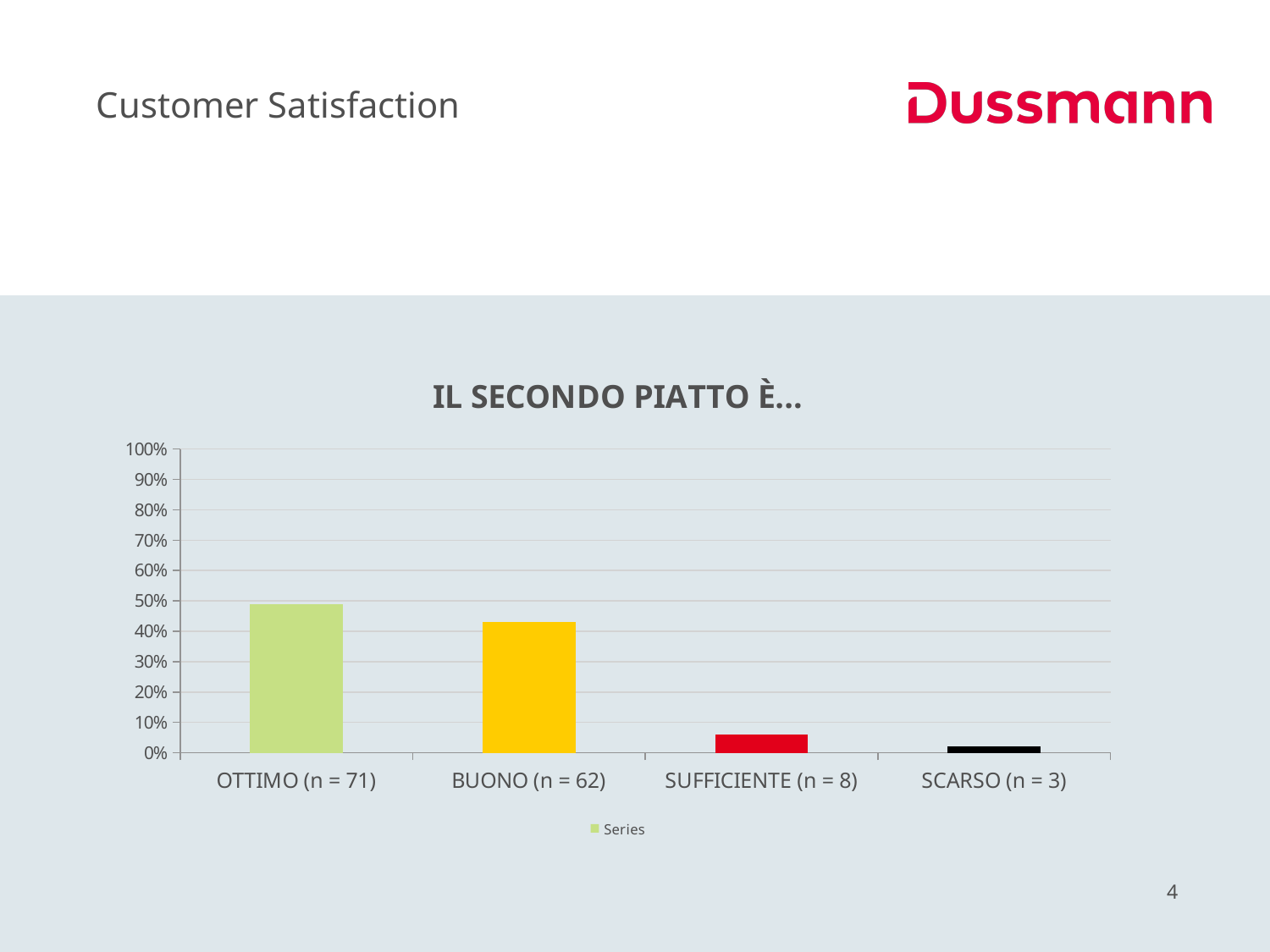
What kind of chart is shown on the slide? bar chart What is the title of the chart? IL SECONDO PIATTO È... Which is larger, the value for OTTIMO (n = 71) or the value for BUONO (n = 62)? OTTIMO (n = 71) Do the bar values rise or fall from left to right along the x axis? fall Is the value for BUONO (n = 62) greater or less than 50%? less How many categories are shown on the x axis of the chart? 4 Which category has the highest bar in the chart? OTTIMO (n = 71) Is the value for OTTIMO (n = 71) greater or less than 40%? greater Is the value for SUFFICIENTE (n = 8) greater or less than 10%? less Which category has the lowest bar in the chart? SCARSO (n = 3) How many series does the chart legend list? 1 Which is larger, the value for SUFFICIENTE (n = 8) or the value for SCARSO (n = 3)? SUFFICIENTE (n = 8)